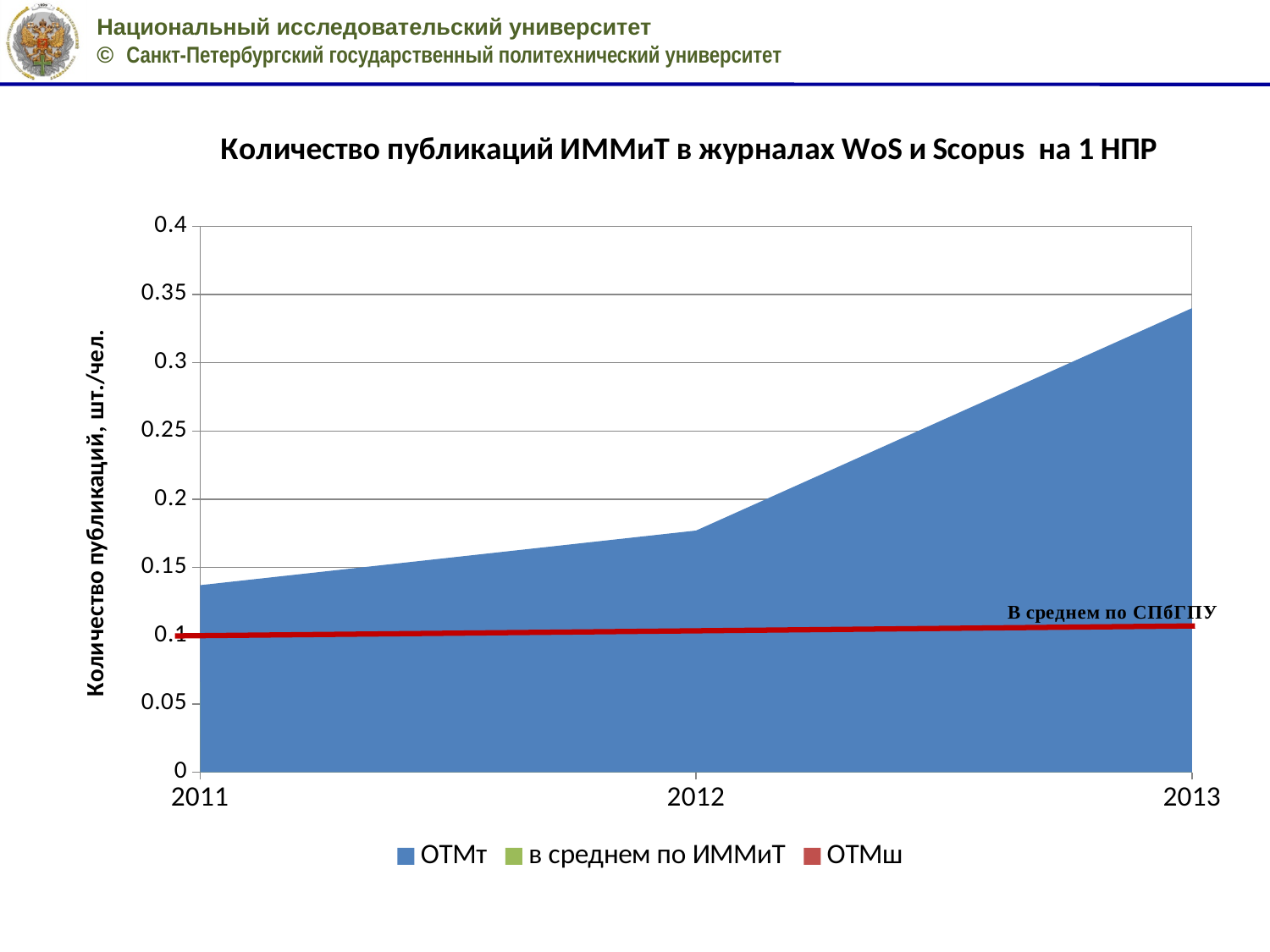
In which year is the value for ОТМт lowest? 2011 What kind of chart is shown on the slide? area chart Is the value for ОТМт in 2012 greater or less than 0.15? greater How many years are shown on the x axis? 3 In which year is the value for ОТМт highest? 2013 What is the title of the chart? Количество публикаций ИММиТ в журналах WoS и Scopus на 1 НПР Is the value for ОТМт in 2012 greater or less than 0.2? less Does the value for ОТМт rise or fall from 2011 to 2013? rise What is the label on the y axis? Количество публикаций, шт./чел. How many series does the legend list? 3 Is the value for ОТМт in 2013 greater or less than 0.3? greater